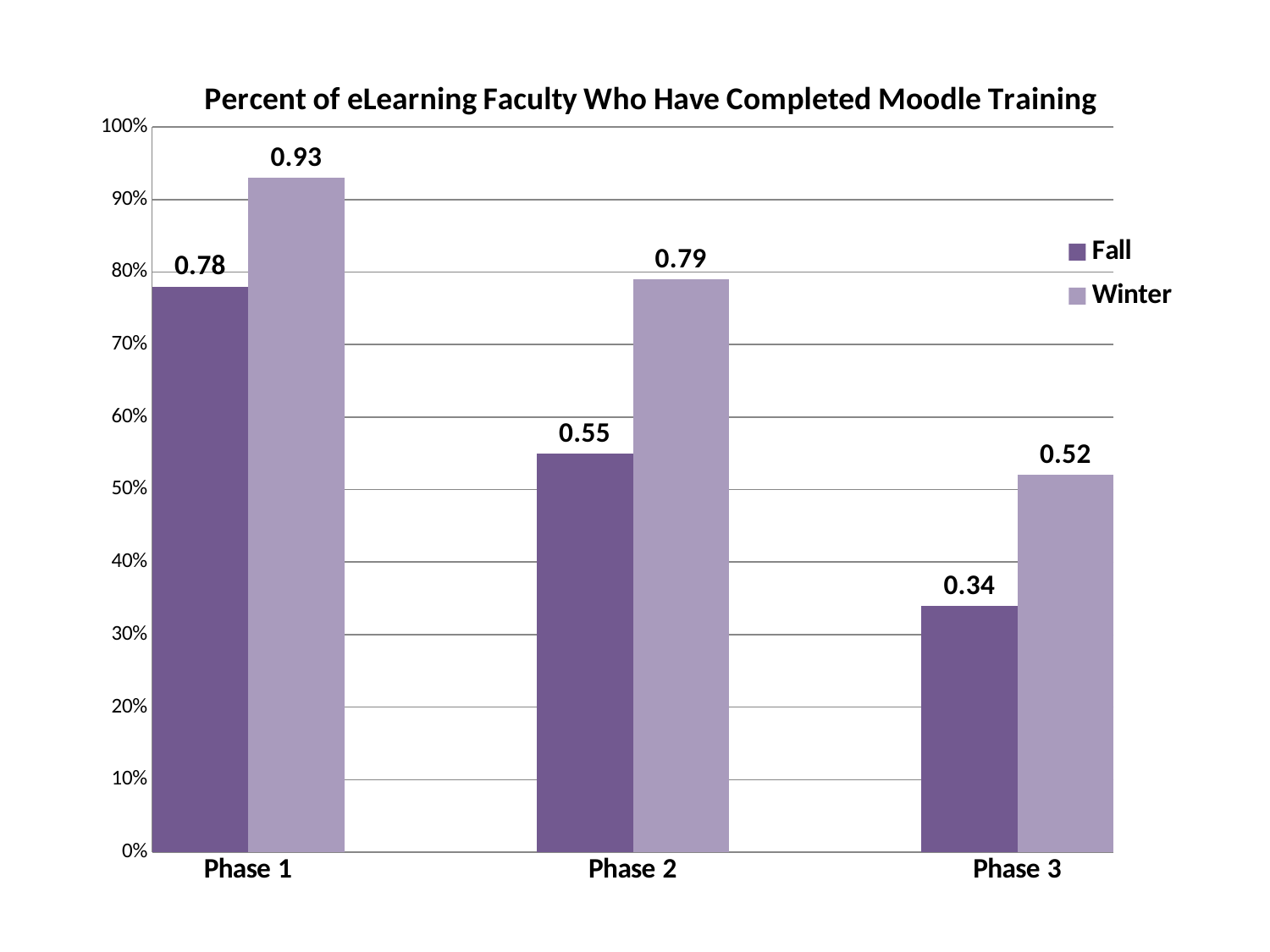
Which is larger for Phase 3, the Fall value or the Winter value? Winter Is the Winter value for Phase 1 greater or less than 90%? greater What is the Fall value for Phase 3? 0.34 What is the difference between the Winter and Fall values for Phase 2? 0.24 Which phase has the lowest Fall value? Phase 3 What is the Fall value for Phase 1? 0.78 Do the Fall values rise or fall from Phase 1 to Phase 3? Fall What kind of chart is shown? Bar chart How many series does the legend list? 2 Which phase has the highest Winter value? Phase 1 What is the Winter value for Phase 2? 0.79 How many phases are shown on the x axis? 3